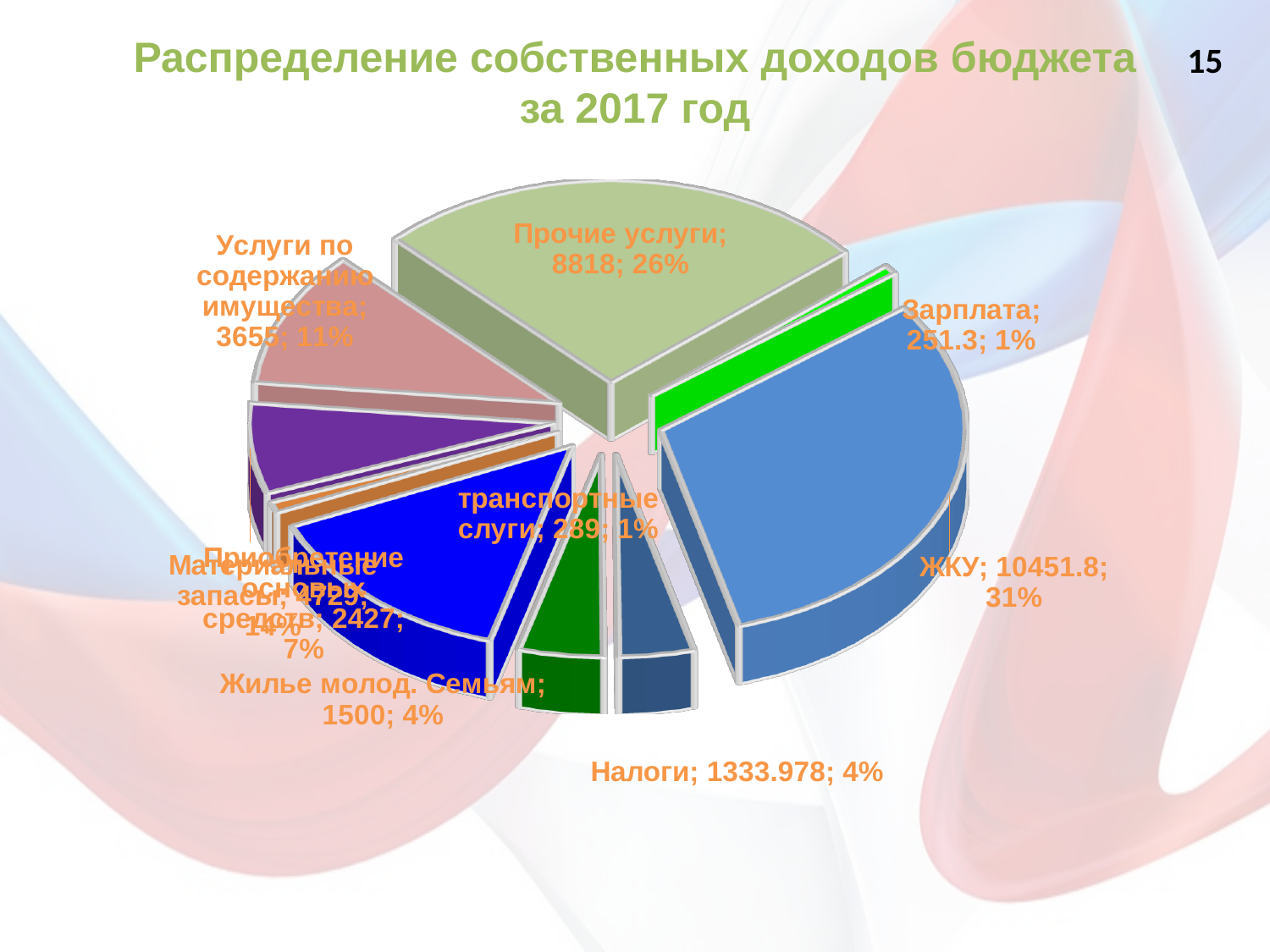
Which category has the smallest value? Зарплата What value is shown for Прочие услуги? 8818 Which category has the largest share of the pie? ЖКУ What share of the pie does Прочие услуги represent? 26% What share of the pie does Жилье молод. Семьям represent? 4% Which is larger, the value for Жилье молод. Семьям or the value for Налоги? Жилье молод. Семьям What is the title of the chart? Распределение собственных доходов бюджета за 2017 год What value is shown for Налоги? 1333.978 What kind of chart is shown on the slide? pie chart What value is shown for ЖКУ? 10451.8 What is the difference between the values for ЖКУ and Прочие услуги? 1633.8 What value is shown for Услуги по содержанию имущества? 3655